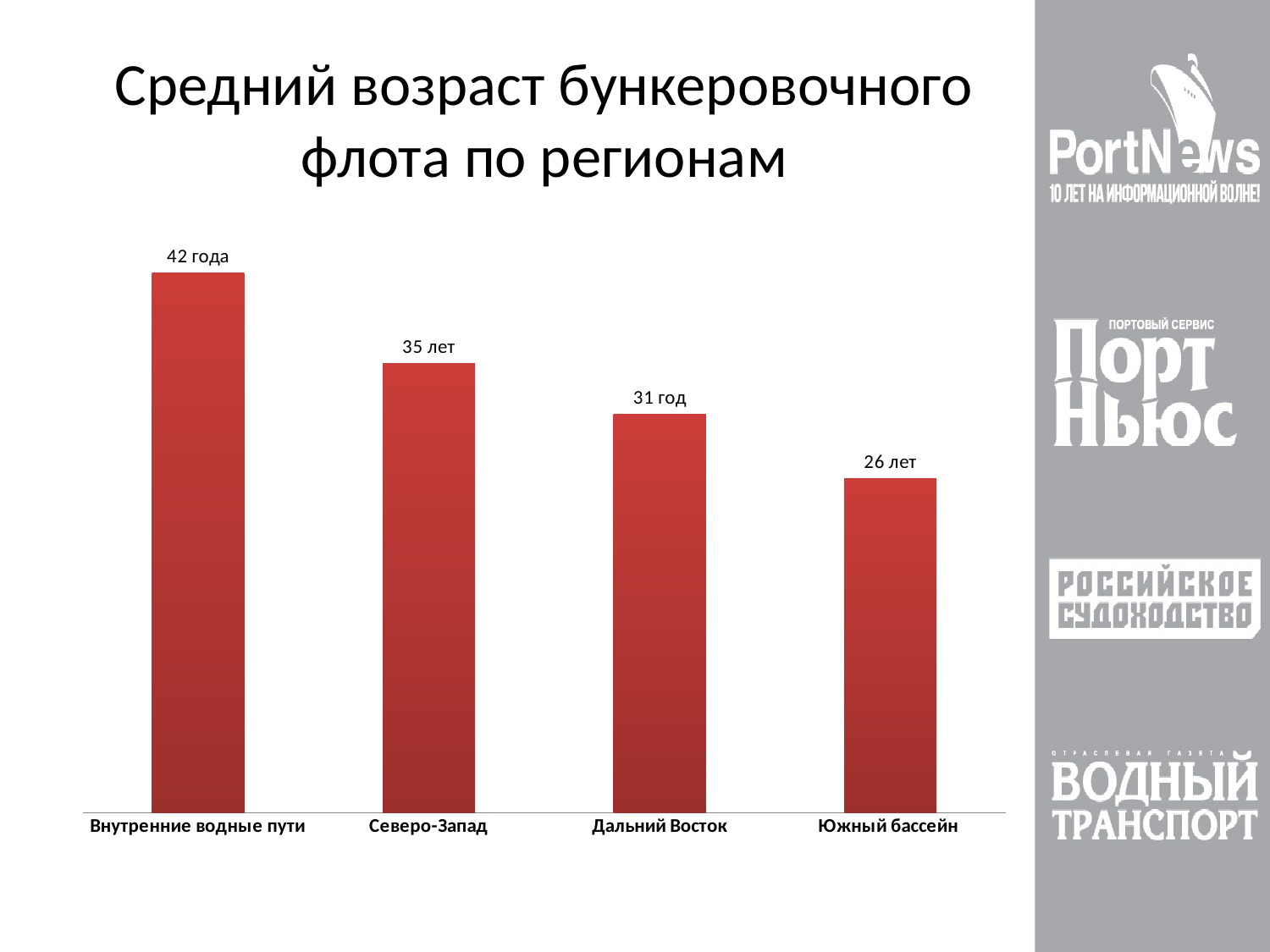
How many regions are shown in the chart? 4 By how many years does the average age for Внутренние водные пути exceed that for Южный бассейн? 16 What is the value shown for Дальний Восток? 31 год What is the difference in years between Северо-Запад and Дальний Восток? 4 Which region has the highest average fleet age? Внутренние водные пути What is the average age of the bunkering fleet for Внутренние водные пути? 42 года Which region has the lowest average fleet age? Южный бассейн What kind of chart is shown on the slide? Bar chart Which has a higher average fleet age, Северо-Запад or Дальний Восток? Северо-Запад Do the values rise or fall from left to right across the regions? Fall What is the value shown for Северо-Запад? 35 лет What is the value shown for Южный бассейн? 26 лет